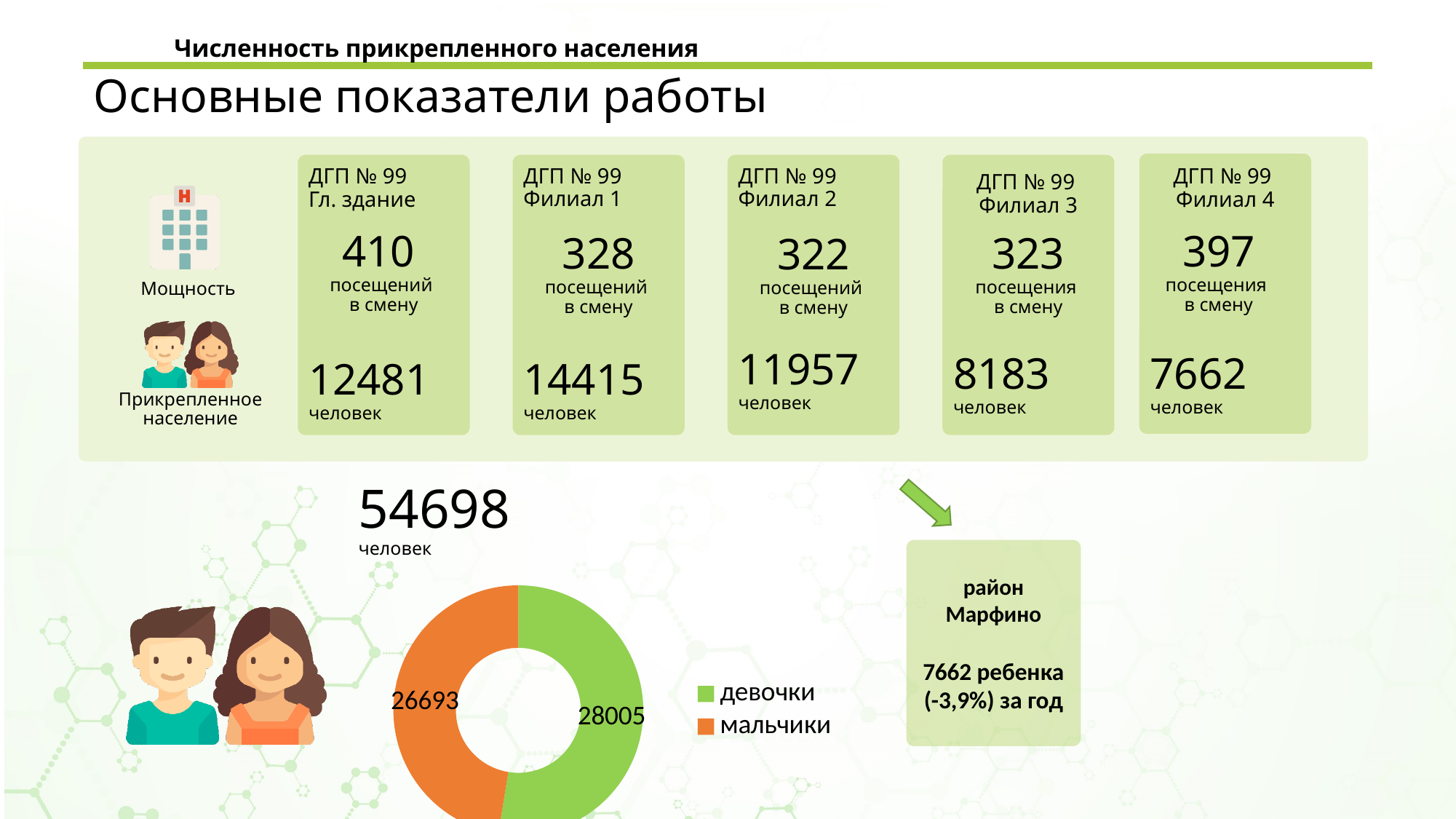
Which category has the larger value in the donut chart, девочки or мальчики? девочки How many entries does the legend of the donut chart list? 2 Which category has the largest value in the donut chart? девочки Which category has the smallest value in the donut chart? мальчики What value is shown for мальчики in the donut chart? 26693 How many categories does the donut chart show? 2 Which colour represents мальчики in the donut chart? orange What kind of chart is shown at the bottom of the slide? pie chart (donut) What is the total of the two slices in the donut chart? 54698 What value is shown for девочки in the donut chart? 28005 What is the difference between the values for девочки and мальчики in the donut chart? 1312